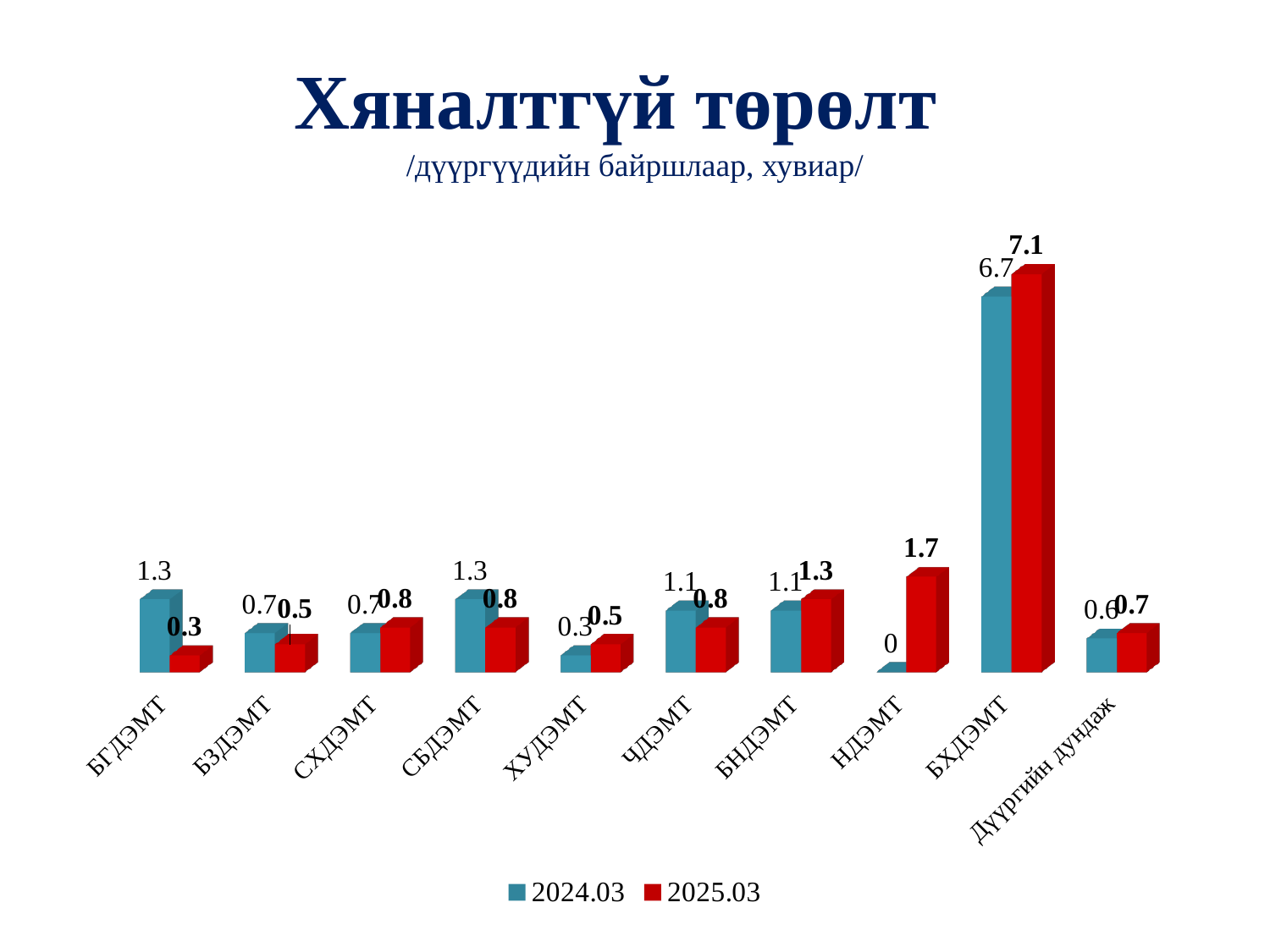
Which category has the highest value in the 2024.03 series? БХДЭМТ What is the title of the chart on the slide? Хяналтгүй төрөлт What is the difference between the 2025.03 and 2024.03 values for БХДЭМТ? 0.4 Which is larger for НДЭМТ: the 2024.03 value or the 2025.03 value? 2025.03 What is the value for Дүүргийн дундаж in the 2025.03 series? 0.7 What kind of chart is shown on the slide? Bar chart Which category has the lowest value in the 2024.03 series? НДЭМТ How many series does the legend list? 2 What is the value for НДЭМТ in the 2024.03 series? 0 What is the value for БХДЭМТ in the 2025.03 series? 7.1 How many categories are shown on the x axis? 10 What is the difference between the 2024.03 and 2025.03 values for БГДЭМТ? 1.0